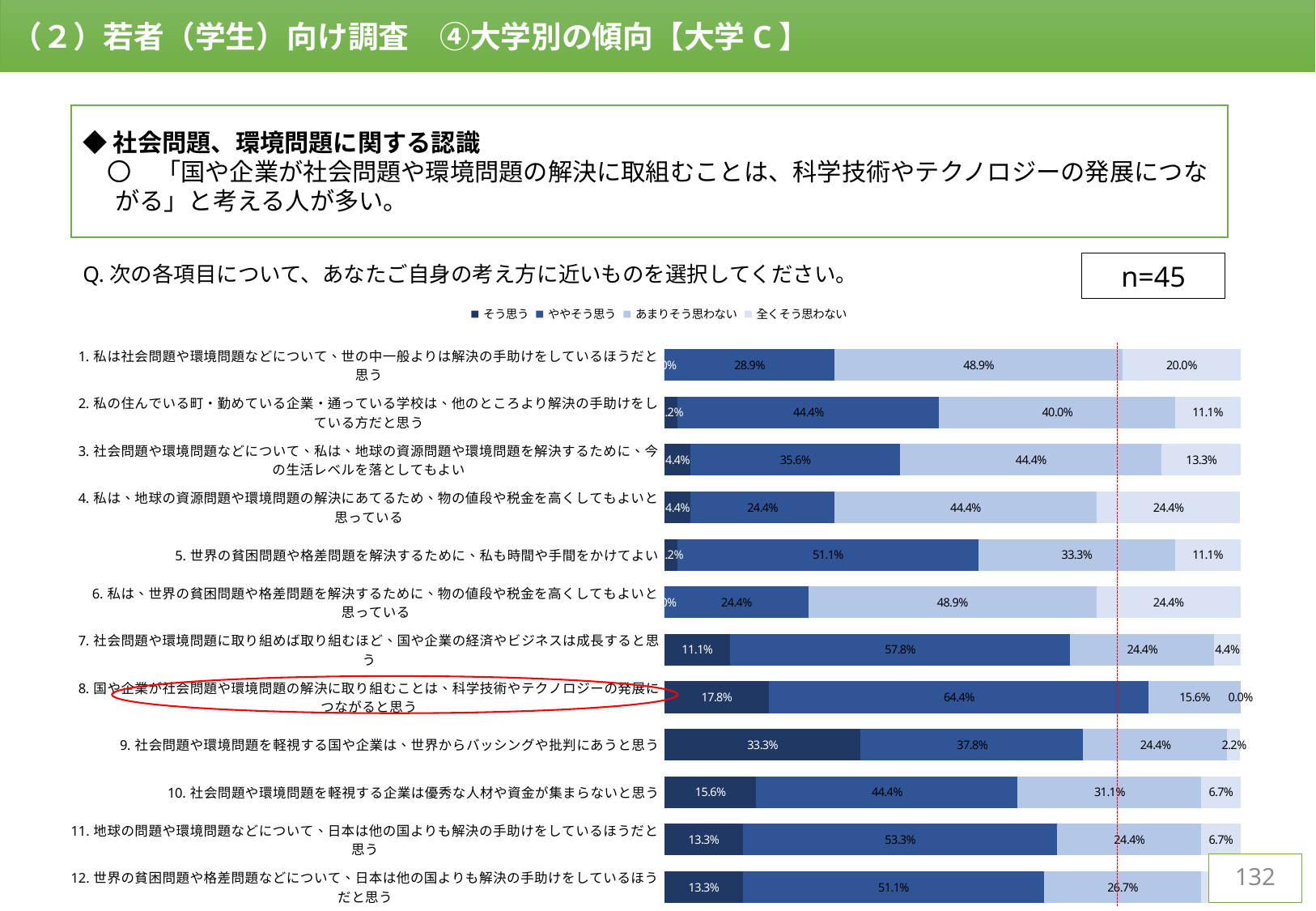
What is the そう思う value for item 9 (社会問題や環境問題を軽視する国や企業は、世界からバッシングや批判にあうと思う)? 33.3% Which is larger: the あまりそう思わない value for item 2 or for item 3? Item 3 (44.4%) What is the あまりそう思わない value for item 1 (私は社会問題や環境問題などについて、世の中一般よりは解決の手助けをしているほうだと思う)? 48.9% How many statement categories are plotted in the chart? 12 Which item has the highest ややそう思う value? Item 8 (国や企業が社会問題や環境問題の解決に取り組むことは、科学技術やテクノロジーの発展につながると思う) What is the sample size (n) shown on the slide? n=45 What is the 全くそう思わない value for item 8? 0.0% What type of chart is shown on the slide? Stacked bar chart Which item has the highest そう思う value? Item 9 (社会問題や環境問題を軽視する国や企業は、世界からバッシングや批判にあうと思う) What is the ややそう思う value for item 8 (国や企業が社会問題や環境問題の解決に取り組むことは、科学技術やテクノロジーの発展につながると思う)? 64.4% How many series does the chart legend list? 4 What is the difference between the ややそう思う values for item 8 (64.4%) and item 7 (57.8%)? 6.6 percentage points